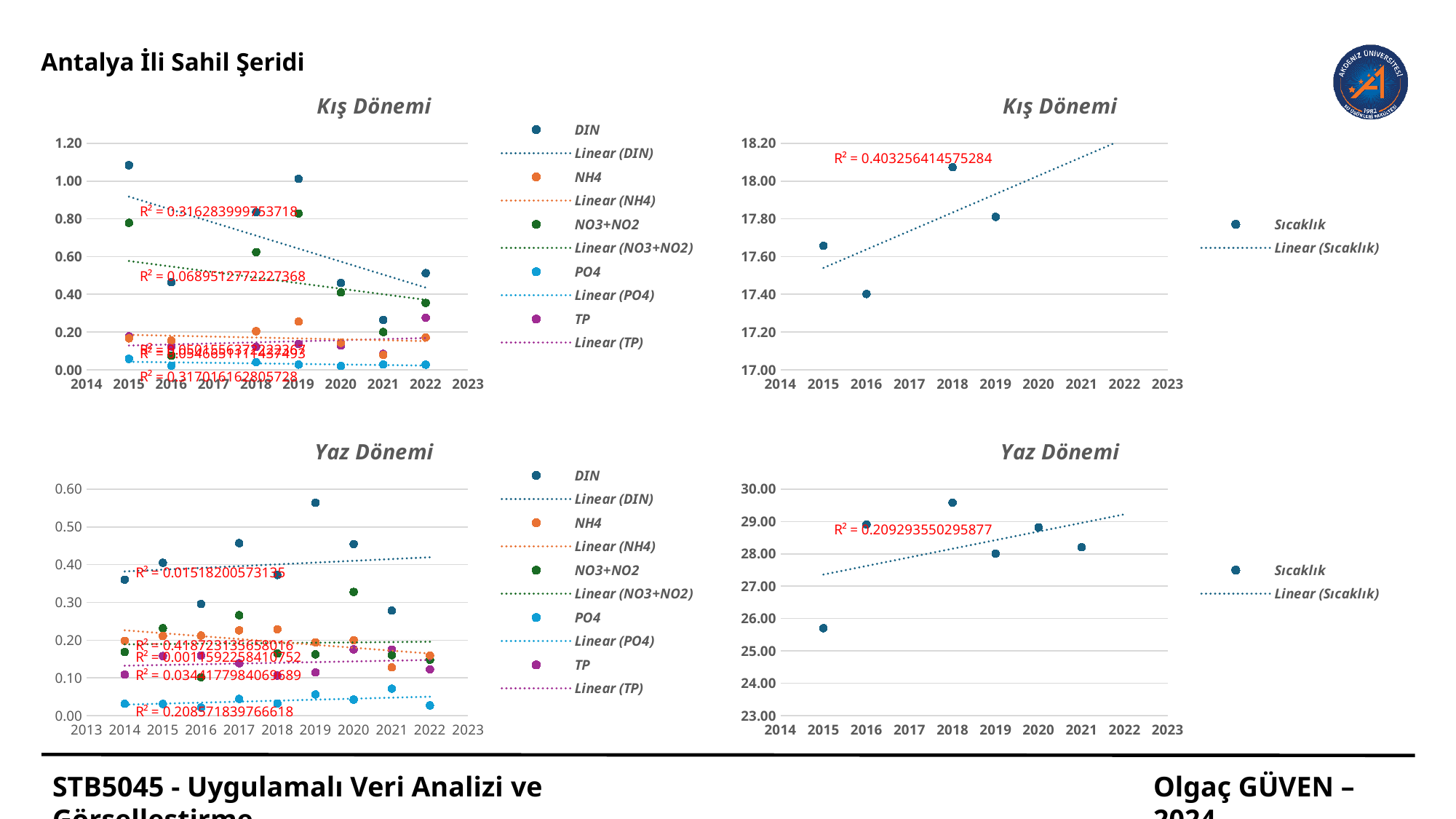
In the bottom-right 'Yaz Dönemi' chart, is the Sıcaklık value for 2015 greater or less than 26.00? less What kind of chart is the top-right 'Kış Dönemi' chart? scatter chart What R² value is shown on the top-right 'Kış Dönemi' chart? R² = 0.403256414575284 In the top-right 'Kış Dönemi' chart, is the Sıcaklık value for 2018 greater or less than 18.00? greater How many entries does the legend of the top-left 'Kış Dönemi' chart list? 10 In the top-left 'Kış Dönemi' chart, does the Linear (DIN) trendline rise or fall from 2015 to 2022? fall How many data points are plotted in the bottom-right 'Yaz Dönemi' chart? 6 How many data points are plotted in the top-right 'Kış Dönemi' chart? 4 In the bottom-left 'Yaz Dönemi' chart, which year has the highest DIN value? 2019 In the bottom-right 'Yaz Dönemi' chart, is the Sıcaklık value for 2018 greater or less than 29.00? greater In the top-right 'Kış Dönemi' chart, does the Linear (Sıcaklık) trendline rise or fall from 2015 to 2022? rise